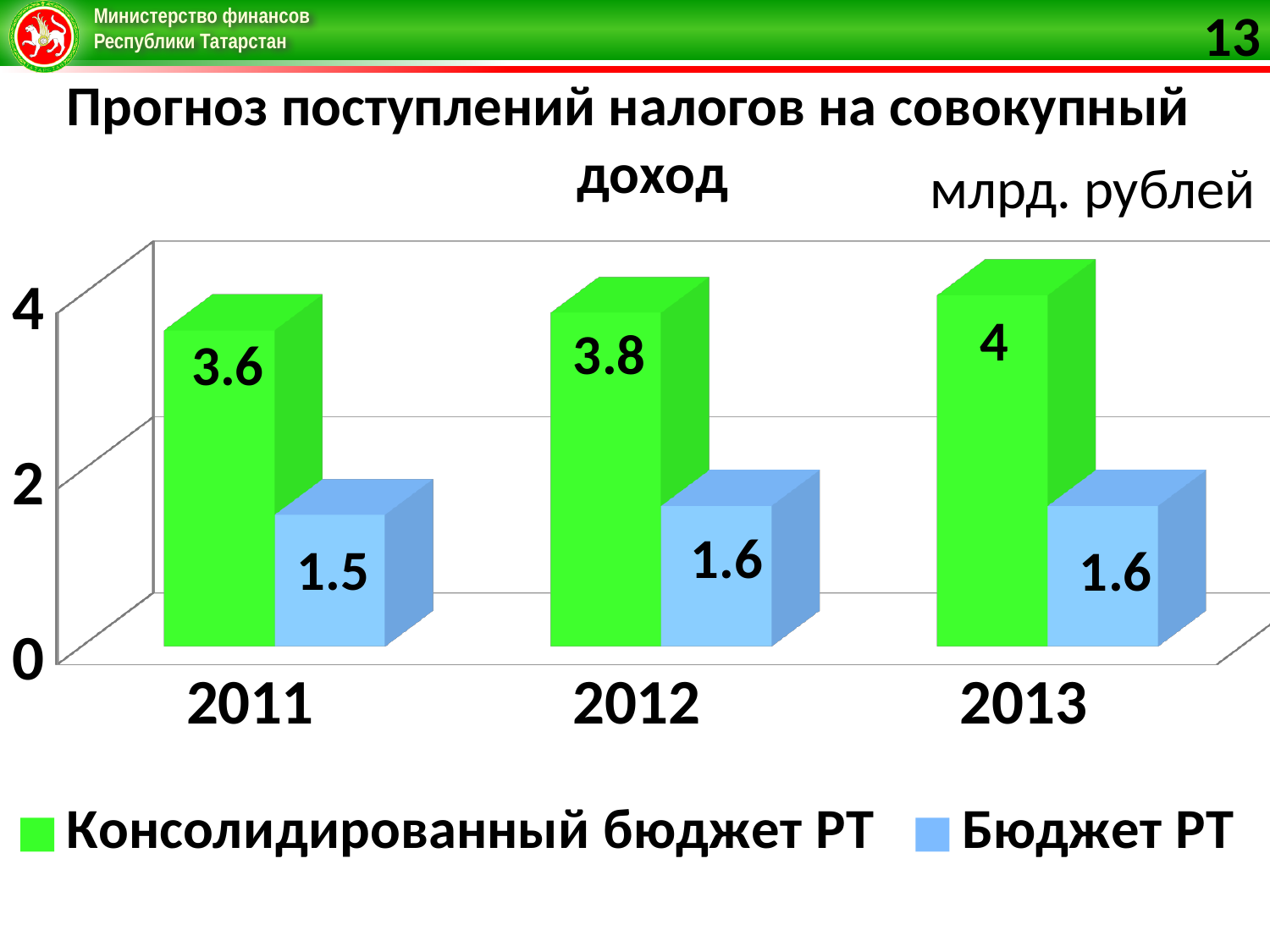
How many series does the legend list? 2 What unit is stated for the values on the chart? млрд. рублей Which is larger in 2013: Консолидированный бюджет РТ or Бюджет РТ? Консолидированный бюджет РТ What is the value for Консолидированный бюджет РТ in 2013? 4 How many years are shown on the x axis? 3 What kind of chart is shown on the slide? bar chart What is the difference between Консолидированный бюджет РТ and Бюджет РТ in 2011? 2.1 What is the value for Бюджет РТ in 2011? 1.5 Which year has the lowest value for Бюджет РТ? 2011 Do the values for Консолидированный бюджет РТ rise or fall from 2011 to 2013? rise Which year has the highest value for Консолидированный бюджет РТ? 2013 What is the value for Консолидированный бюджет РТ in 2012? 3.8